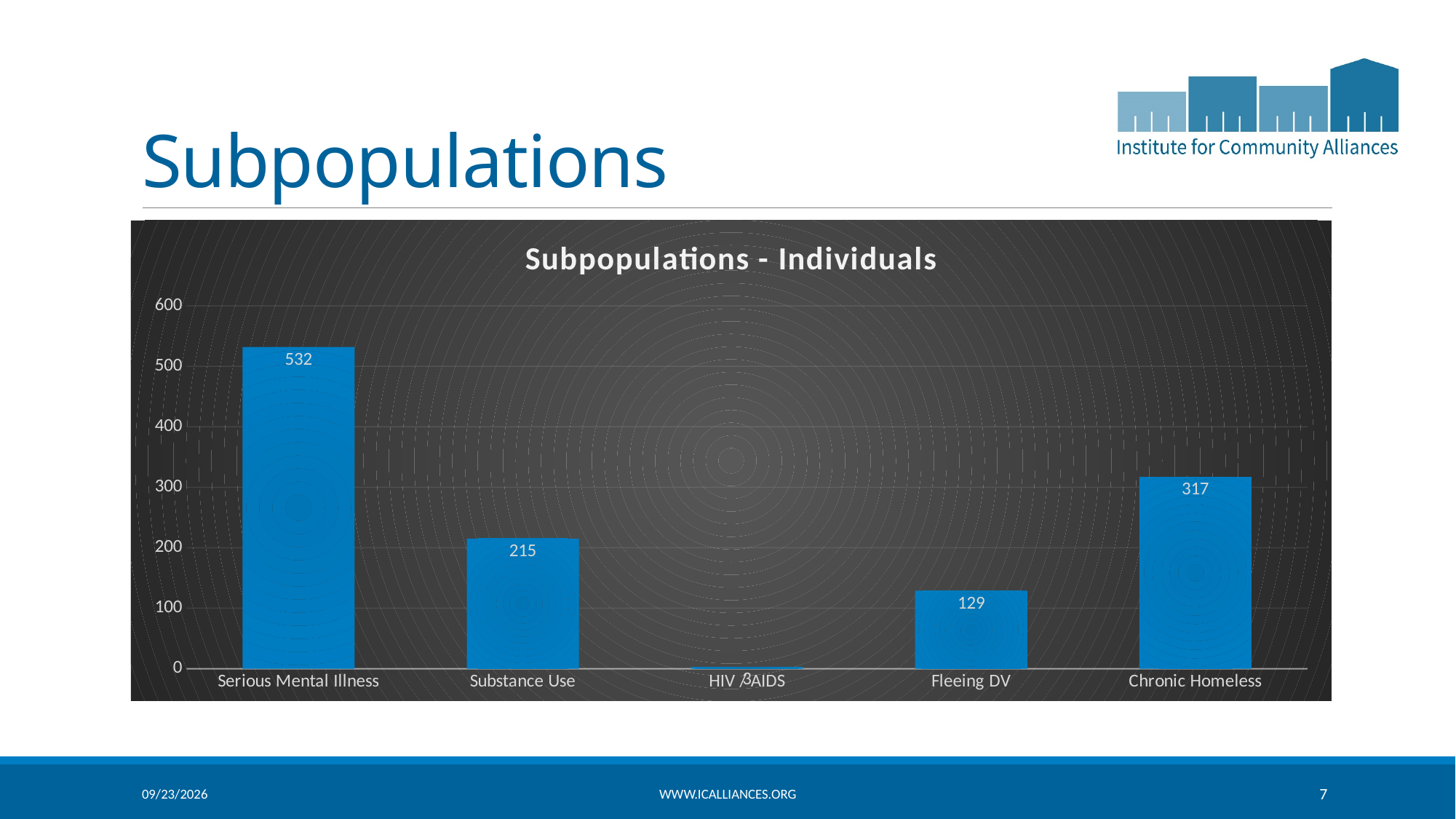
What is the value for Chronic Homeless? 317 Which category has the highest value? Serious Mental Illness What is the difference between the values for Serious Mental Illness and Chronic Homeless? 215 Which is larger, the value for Substance Use or the value for Chronic Homeless? Chronic Homeless What is the value for Fleeing DV? 129 Is the value for Fleeing DV greater or less than 200? less What kind of chart is shown on the slide? Bar chart Which category has the lowest value? HIV/AIDS What is the difference between the values for Substance Use and Fleeing DV? 86 How many categories are shown on the chart? 5 What is the value for Serious Mental Illness? 532 What is the value for Substance Use? 215